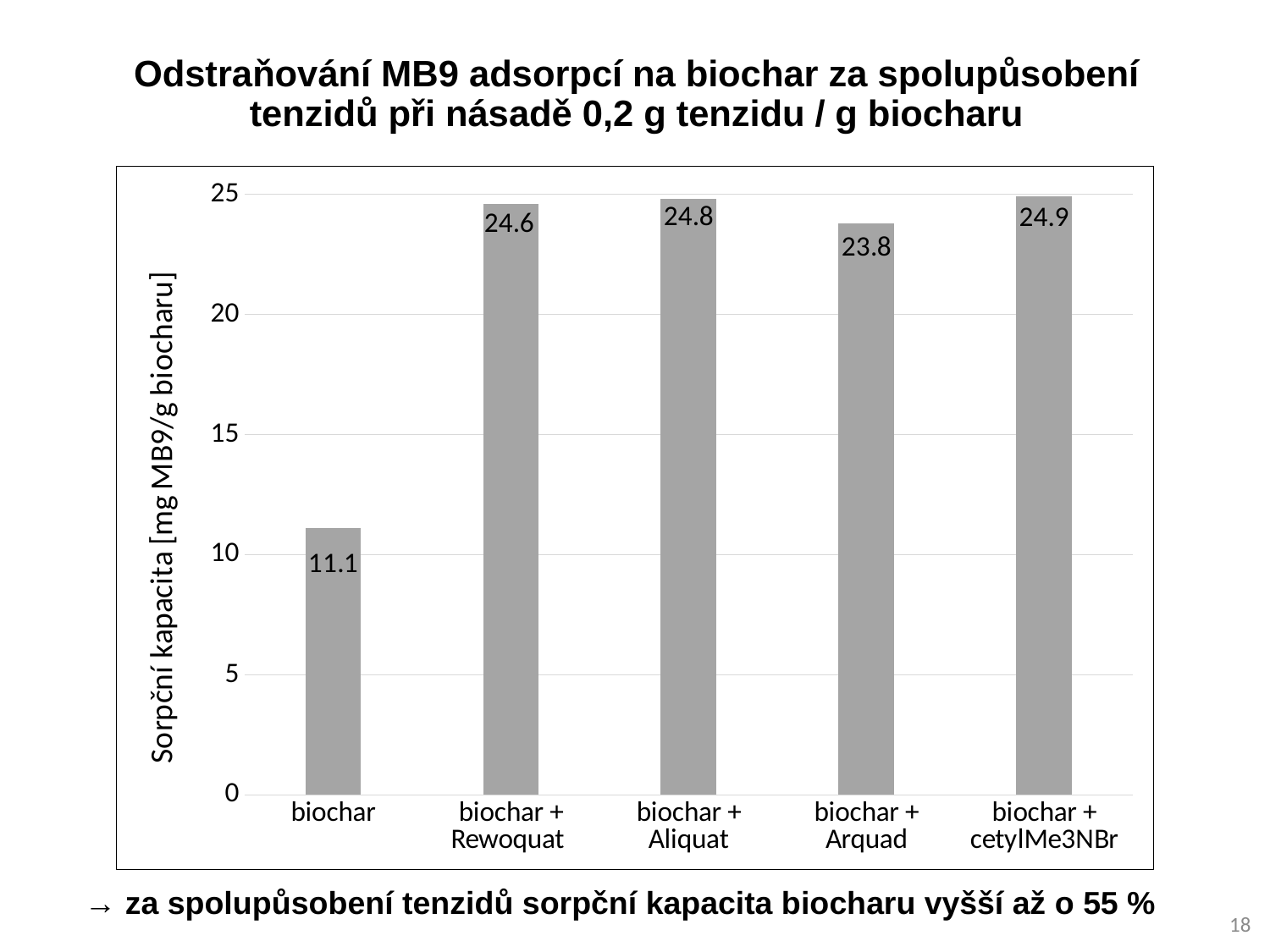
Which category has the highest sorption capacity according to the data labels? biochar + cetylMe3NBr Which has a higher sorption capacity, biochar + Rewoquat or biochar + Arquad? biochar + Rewoquat What is the sorption capacity for biochar + cetylMe3NBr? 24.9 What is the difference in sorption capacity between biochar + Aliquat and biochar alone? 13.7 What is the sorption capacity for biochar + Rewoquat? 24.6 What is the sorption capacity for biochar alone? 11.1 How many categories are shown on the x axis? 5 What type of chart is shown on the slide? bar chart What is the label of the y axis? Sorpční kapacita [mg MB9/g biocharu] What is the sorption capacity for biochar + Arquad? 23.8 Is the value for biochar + Arquad greater or less than 20? greater Which category has the lowest sorption capacity? biochar